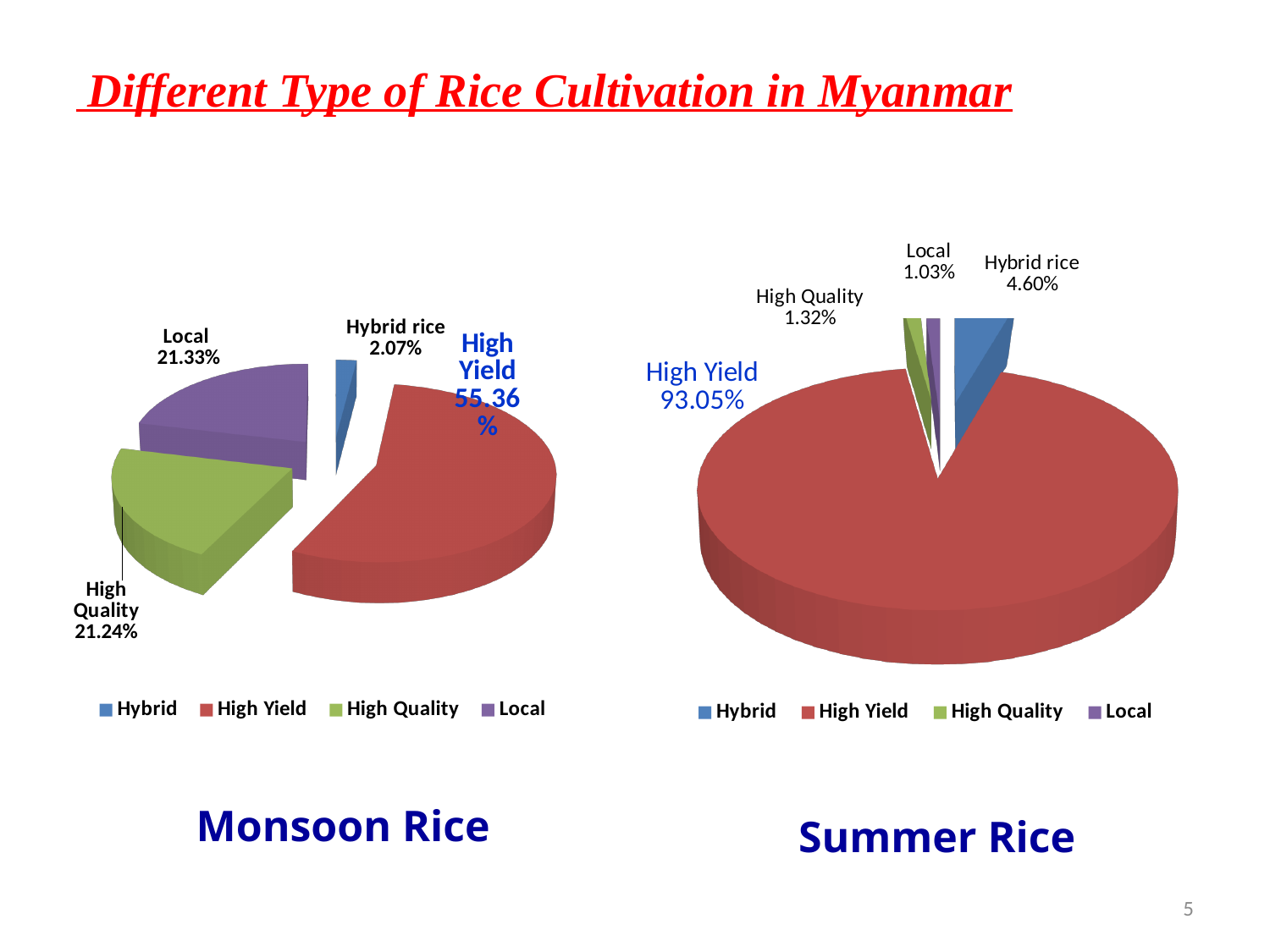
What type of chart is used for Summer Rice? Pie chart In the Summer Rice chart, which category has the smallest share? Local How many categories does the legend of the Monsoon Rice chart list? 4 In the Monsoon Rice chart, which category has the smallest share? Hybrid rice In the Summer Rice chart, which category has the largest share? High Yield In the Summer Rice chart, what share does Hybrid rice have? 4.60% What is the difference between the High Yield share in the Summer Rice chart and the High Yield share in the Monsoon Rice chart? 37.69% Is the Hybrid rice share larger in the Monsoon Rice chart or the Summer Rice chart? Summer Rice In the Monsoon Rice chart, what share does High Quality rice have? 21.24% In the Monsoon Rice chart, what is the difference between the Local share and the High Quality share? 0.09% In the Monsoon Rice chart, what share does High Yield rice have? 55.36% In the Summer Rice chart, what share does Local rice have? 1.03%